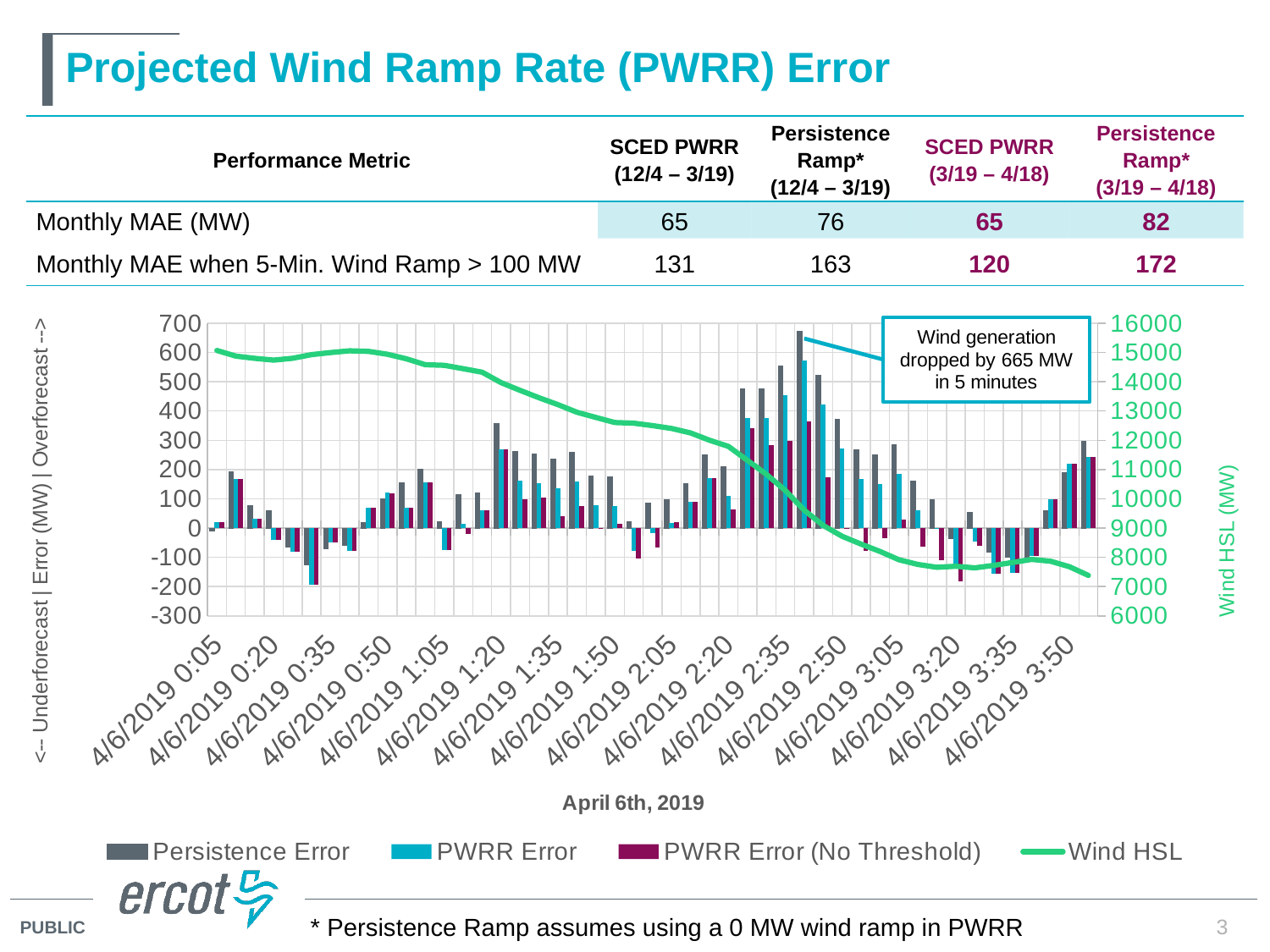
What is the highest tick value shown on the right-hand axis of the chart? 16000 Is the Wind HSL value at 4/6/2019 3:50 greater or less than 8000? less Which series in the chart is drawn as a line rather than bars? Wind HSL What kind of chart is shown on the slide? A combined bar and line chart Does the Wind HSL line generally rise or fall from left to right across the chart? Fall According to the annotation on the chart, by how much did wind generation drop in 5 minutes? 665 MW What is the lowest tick value shown on the left-hand axis of the chart? -300 How many series does the chart legend list? 4 What is the title of the right-hand vertical axis of the chart? Wind HSL (MW) Is the highest Persistence Error bar on the chart greater or less than 600? greater Is the Wind HSL value at 4/6/2019 0:05 greater or less than 14000? greater Which bar series reaches the highest value on the left axis of the chart? Persistence Error